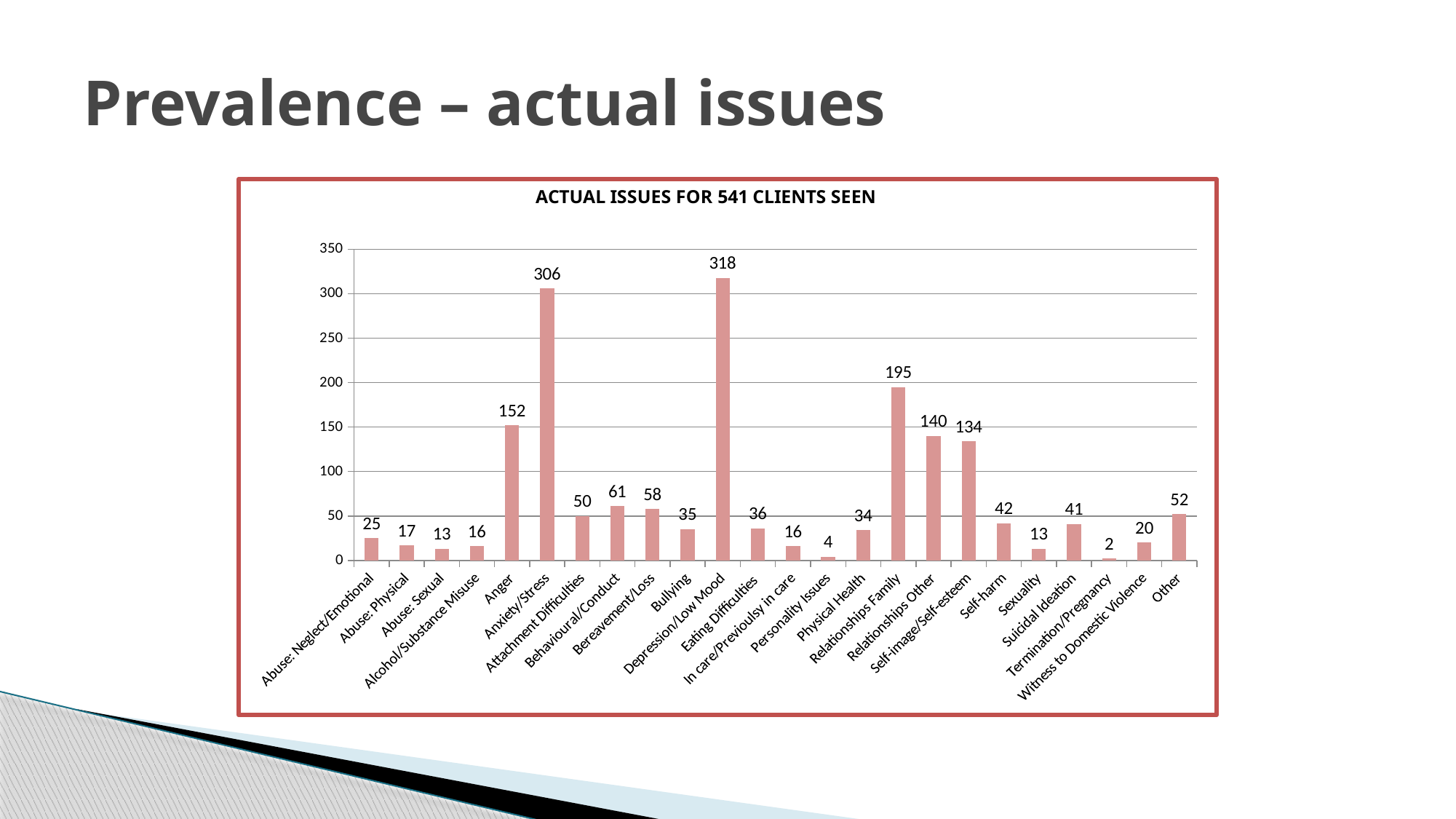
What is the value for Anxiety/Stress? 306 What is the title of the chart? ACTUAL ISSUES FOR 541 CLIENTS SEEN What is the value for Depression/Low Mood? 318 What kind of chart is shown on the slide? Bar chart What is the difference between the values for Behavioural/Conduct and Bereavement/Loss? 3 Is the value for Anger greater or less than 100? greater What is the difference between the values for Depression/Low Mood and Anxiety/Stress? 12 How many categories are shown on the x axis? 24 Which category has the lowest value? Termination/Pregnancy Which category has the highest value? Depression/Low Mood Which is larger, the value for Relationships Other or the value for Self-image/Self-esteem? Relationships Other What is the value for Relationships Family? 195